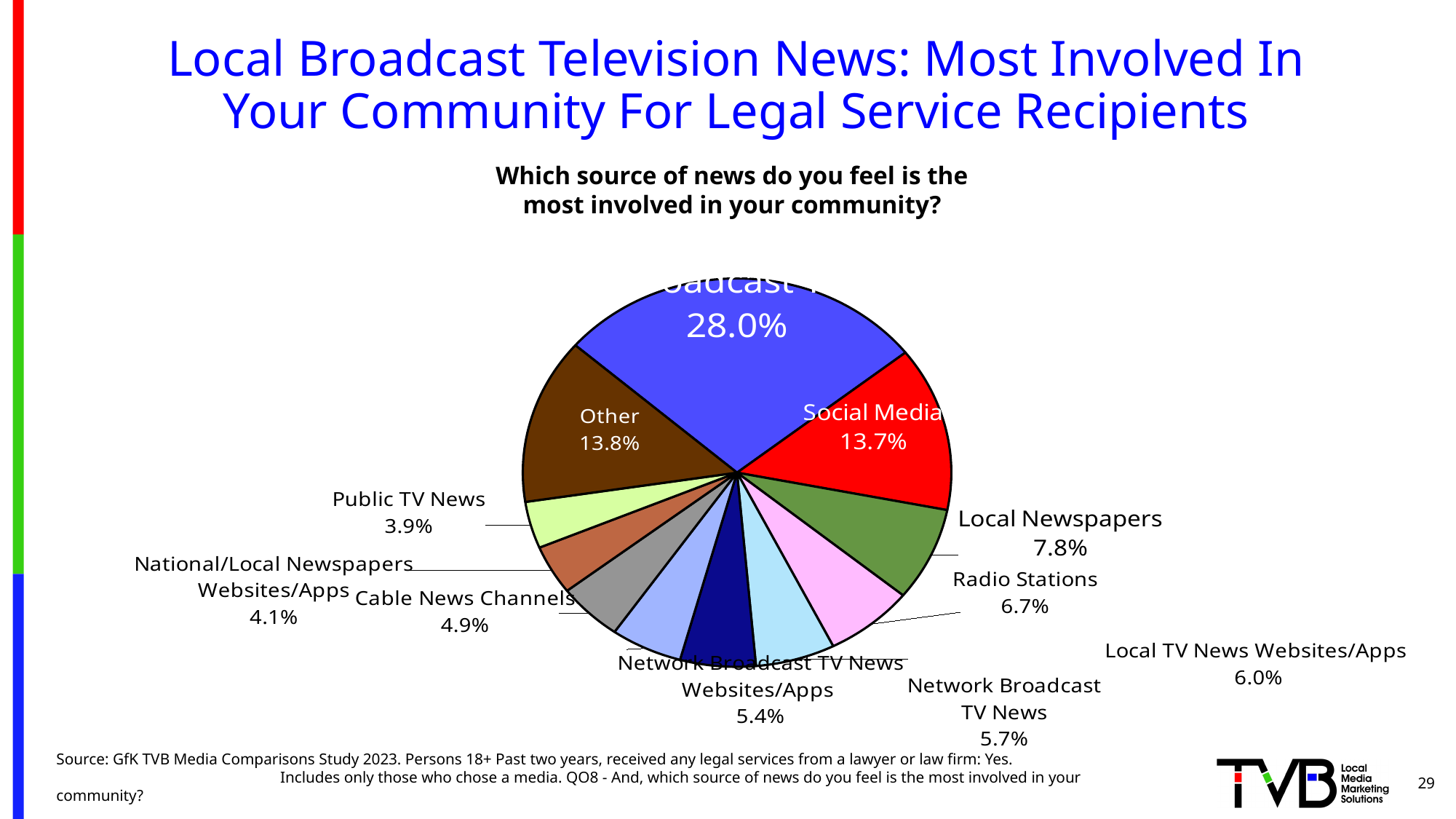
What is the value shown for Radio Stations? 6.7% What is the value shown for Local TV News Websites/Apps? 6.0% What is the value shown for Cable News Channels? 4.9% What type of chart is shown on the slide? pie chart What percentage of respondents chose Social Media as the news source most involved in their community? 13.7% What is the value shown for Network Broadcast TV News Websites/Apps? 5.4% What is the percentage shown on the largest slice of the pie? 28.0% How many slices does the pie chart have? 11 What is the value shown for Local Newspapers? 7.8% What is the difference in percentage points between Network Broadcast TV News (5.7%) and National/Local Newspapers Websites/Apps (4.1%)? 1.6 Which is larger, the share for Local Newspapers or the share for Radio Stations? Local Newspapers Which category has the smallest slice of the pie? Public TV News